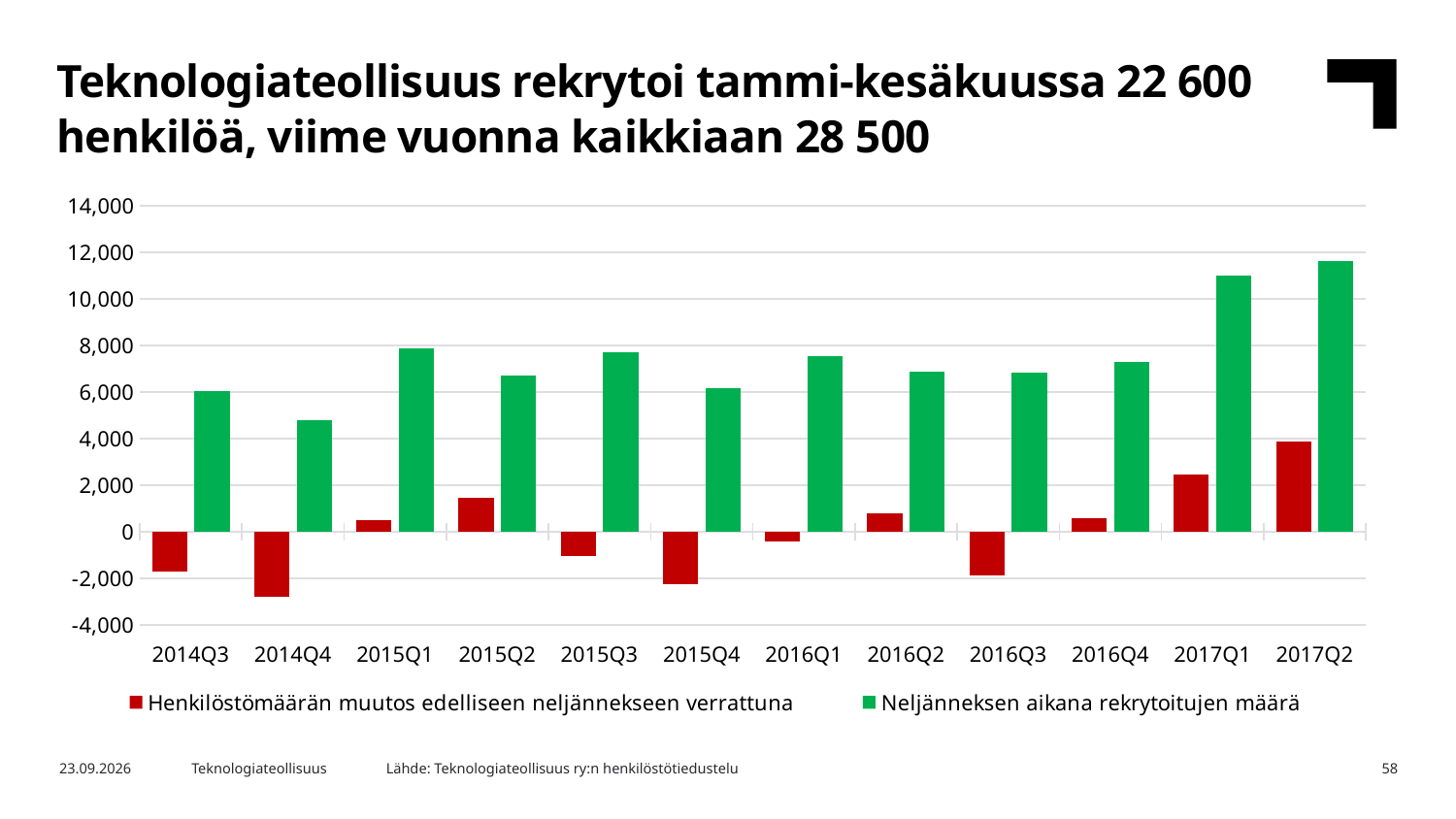
Which quarter has the lowest value for 'Neljänneksen aikana rekrytoitujen määrä'? 2014Q4 Which quarter has the highest value for 'Neljänneksen aikana rekrytoitujen määrä'? 2017Q2 Which quarter has the lowest value for 'Henkilöstömäärän muutos edelliseen neljännekseen verrattuna'? 2014Q4 Is the value for 'Neljänneksen aikana rekrytoitujen määrä' in 2014Q4 greater or less than 6,000? less Is the value for 'Henkilöstömäärän muutos edelliseen neljännekseen verrattuna' in 2014Q4 greater or less than -2,000? less Which quarter has the highest value for 'Henkilöstömäärän muutos edelliseen neljännekseen verrattuna'? 2017Q2 How many quarters are shown on the x axis? 12 How many series does the legend list? 2 Which is larger for 'Neljänneksen aikana rekrytoitujen määrä': 2015Q1 or 2015Q2? 2015Q1 Which series is shown in green? Neljänneksen aikana rekrytoitujen määrä What kind of chart is shown on the slide? bar chart Is the value for 'Neljänneksen aikana rekrytoitujen määrä' in 2017Q1 greater or less than 10,000? greater